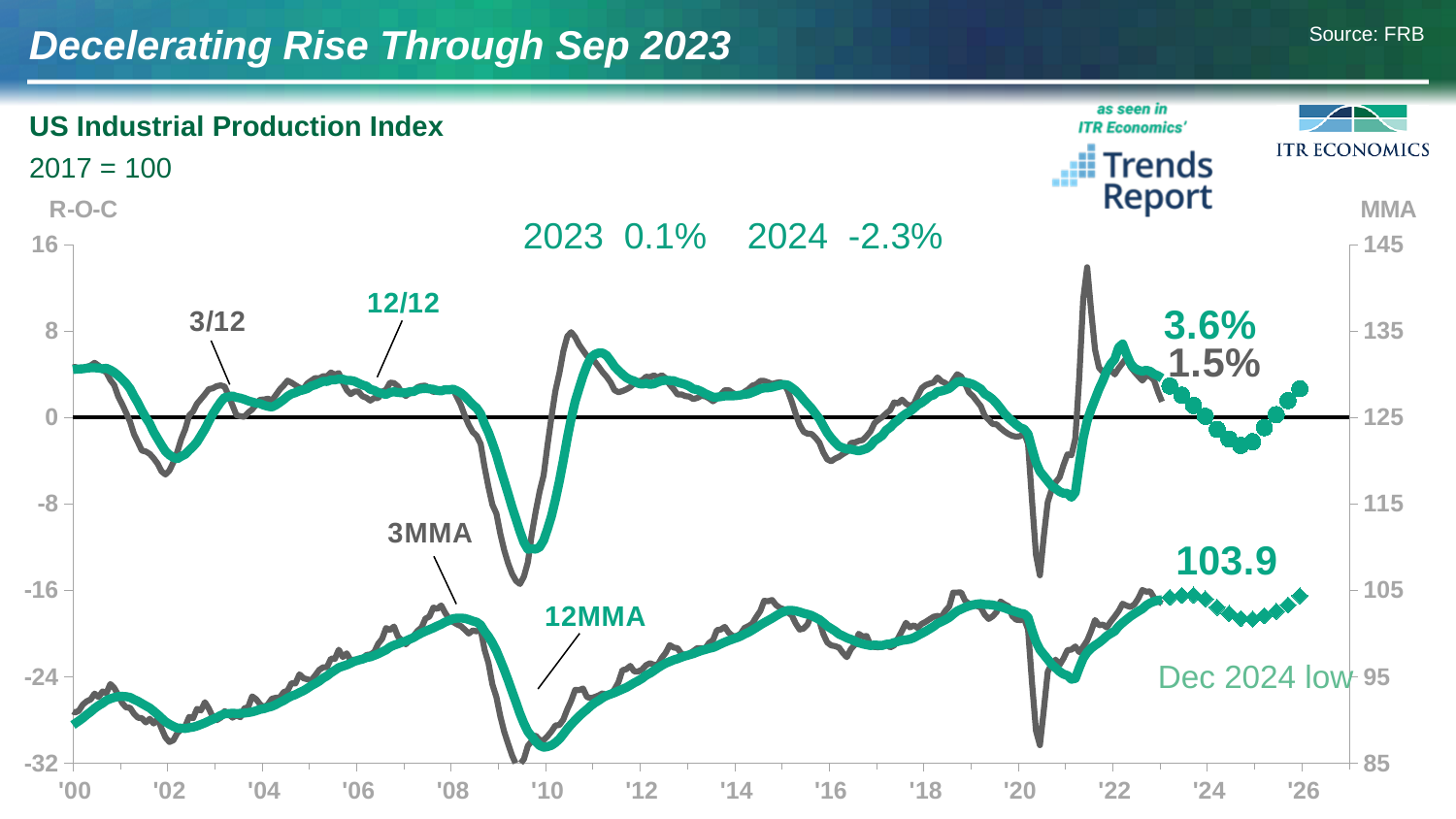
What is the latest 3/12 rate-of-change value labeled on the chart? 1.5% What kind of chart is shown on the slide? line chart What is the forecast annual rate of change shown for 2023? 0.1% How many data series are labeled on the chart? 4 When does the chart indicate the forecast low for the 12MMA will occur? Dec 2024 What is the latest 12/12 rate-of-change value labeled on the chart? 3.6% What base year is the US Industrial Production Index set to 100? 2017 = 100 What is the difference between the latest 12/12 value (3.6%) and the latest 3/12 value (1.5%)? 2.1 percentage points What is the forecast annual rate of change shown for 2024? -2.3% Is the 12/12 rate-of-change trough around 2009 greater or less than -8? less What is the latest 12MMA value labeled on the chart? 103.9 Which is larger, the latest 12/12 value or the latest 3/12 value? 12/12 (3.6%)